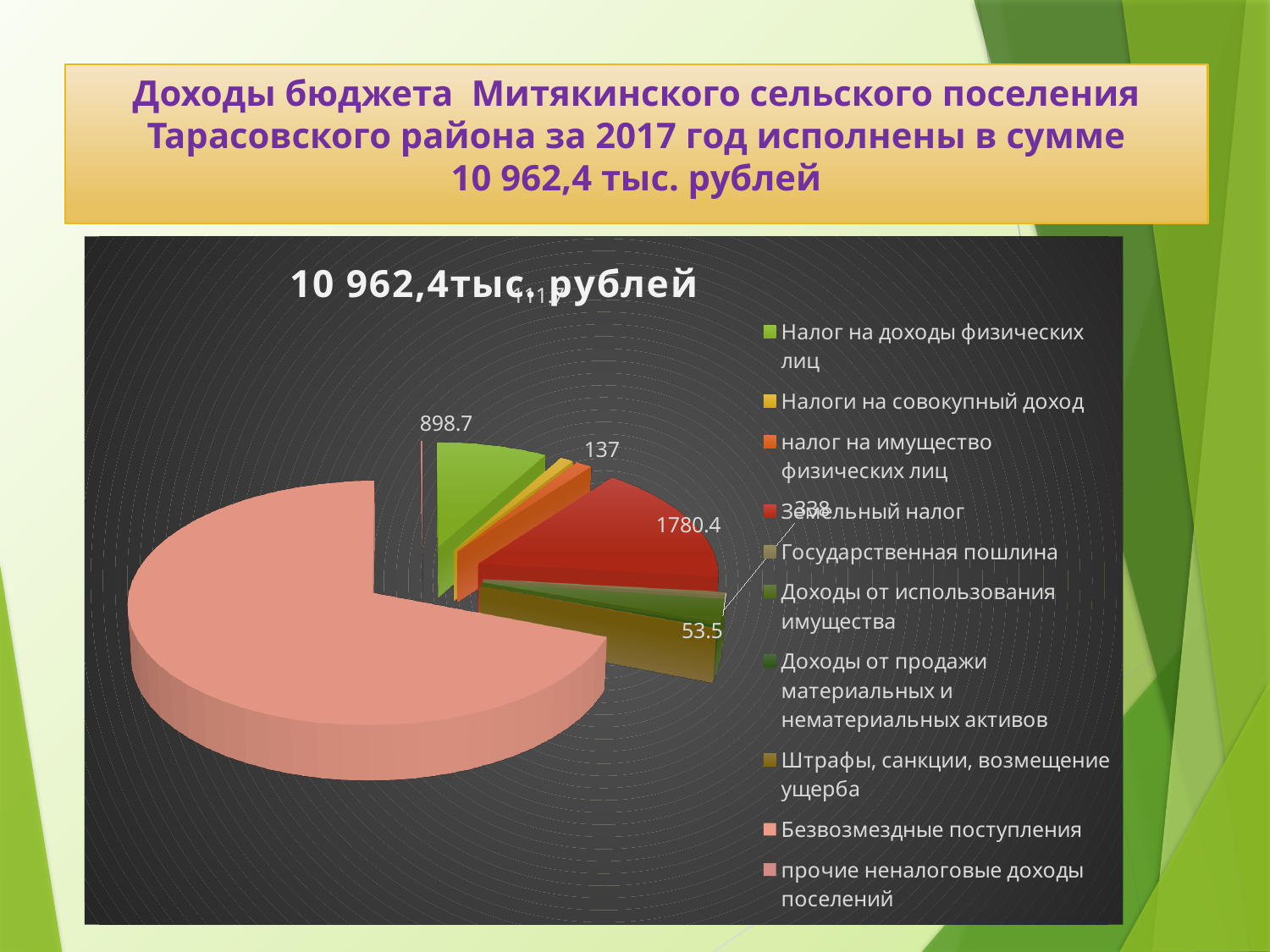
Which is larger, Налог на доходы физических лиц or налог на имущество физических лиц? Налог на доходы физических лиц What is the value shown for Налог на доходы физических лиц? 898.7 What is the value shown for налог на имущество физических лиц? 137 What is the difference between the values for Земельный налог and налог на имущество физических лиц? 1643.4 What colour is the largest slice of the pie chart? pink What kind of chart is shown on the slide? pie chart What is the value shown for Земельный налог? 1780.4 How many categories does the legend of the pie chart list? 10 What is the difference between the values for Земельный налог and Налог на доходы физических лиц? 881.7 According to the slide title, what total amount of budget income was executed in 2017? 10 962,4 тыс. рублей Which is larger, Земельный налог or Налог на доходы физических лиц? Земельный налог What is the title of the pie chart? 10 962,4тыс. рублей